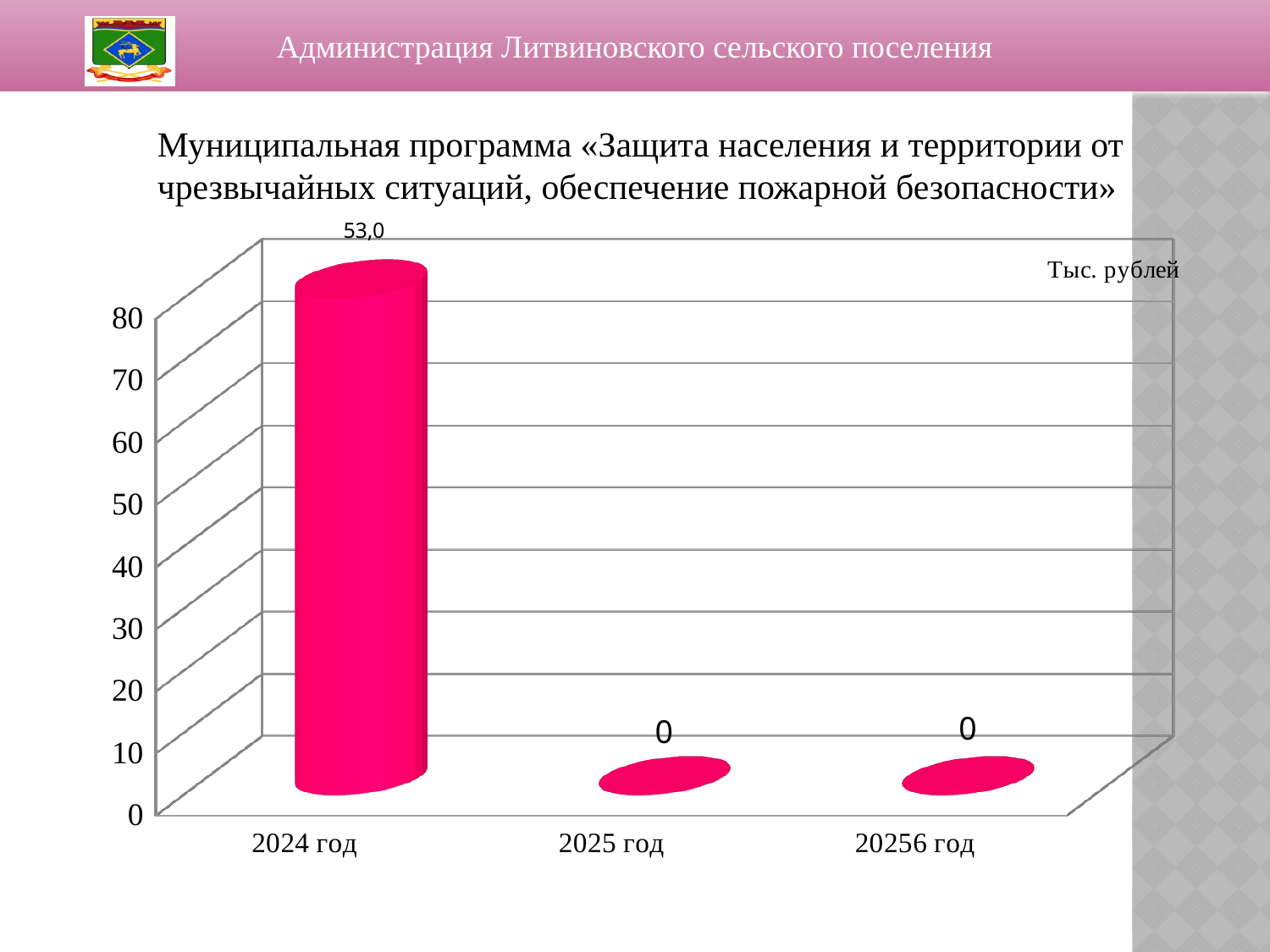
How many categories are shown on the x axis? 3 What colour are the bars in the chart? pink Do the values rise or fall from 2024 год to 2025 год? fall How many categories have a value of 0? 2 Which is larger, the value for 2024 год or the value for 20256 год? 2024 год What unit is indicated for the chart values? Тыс. рублей What is the value for 2025 год? 0 What is the value for 20256 год? 0 Which category has the highest value? 2024 год What is the difference between the values for 2024 год and 2025 год? 53,0 What is the value for 2024 год? 53,0 What kind of chart is shown on the slide? bar chart